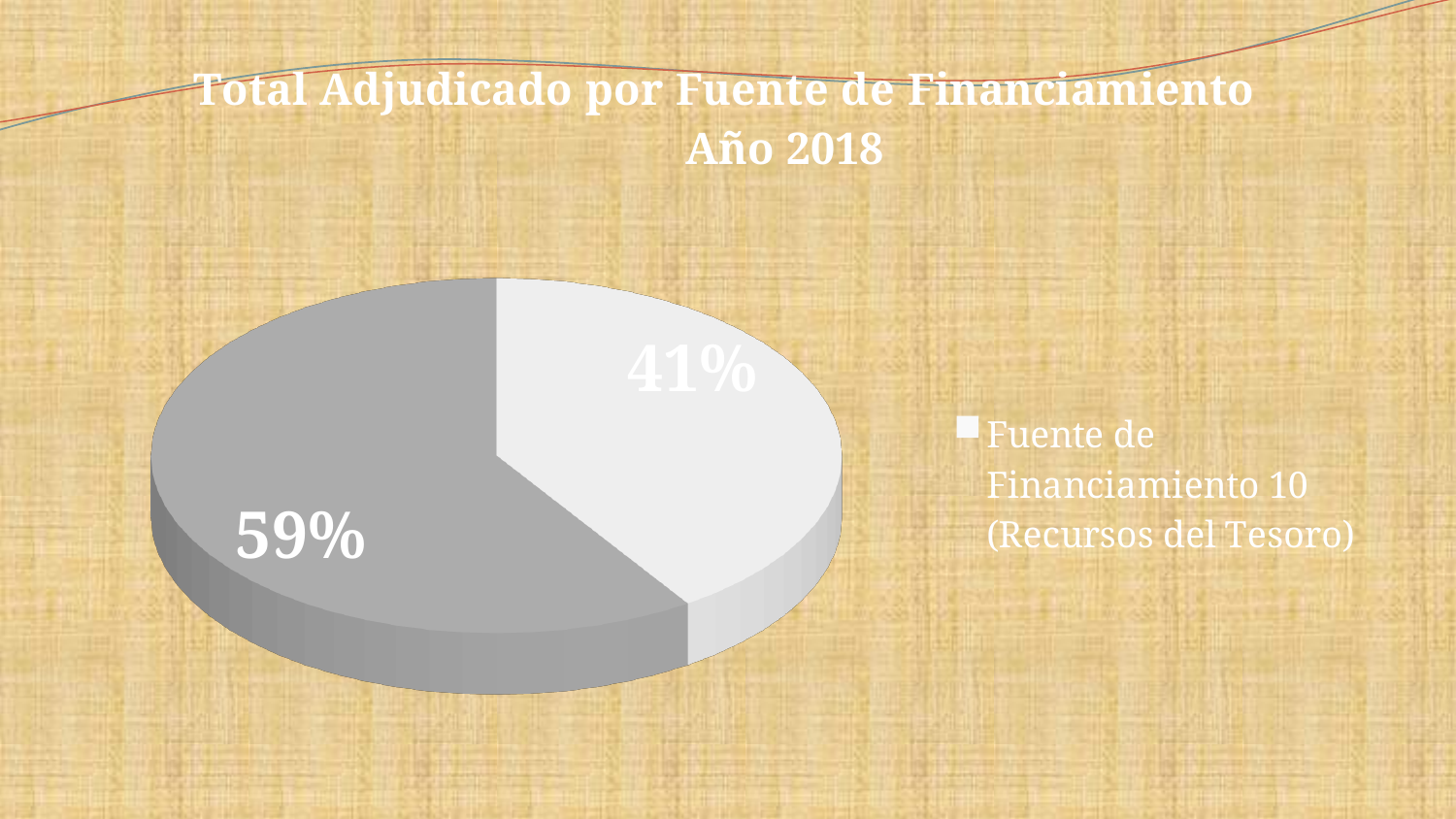
What kind of chart is shown on the slide? Pie chart Is the share of the light slice greater or less than 50%? less What percentage is shown on the largest slice of the pie chart? 59% Is the share of the dark gray slice greater or less than 50%? greater What percentage is shown on the smallest slice of the pie chart? 41% What is the difference in percentage points between the two slices of the pie chart? 18 percentage points Which slice is larger, the one labelled 59% or the one labelled 41%? The one labelled 59% How many slices does the pie chart have? 2 What is the title of the chart? Total Adjudicado por Fuente de Financiamiento Año 2018 What is the legend entry shown next to the pie chart? Fuente de Financiamiento 10 (Recursos del Tesoro) How many entries does the legend list? 1 What do the two slice percentages add up to? 100%